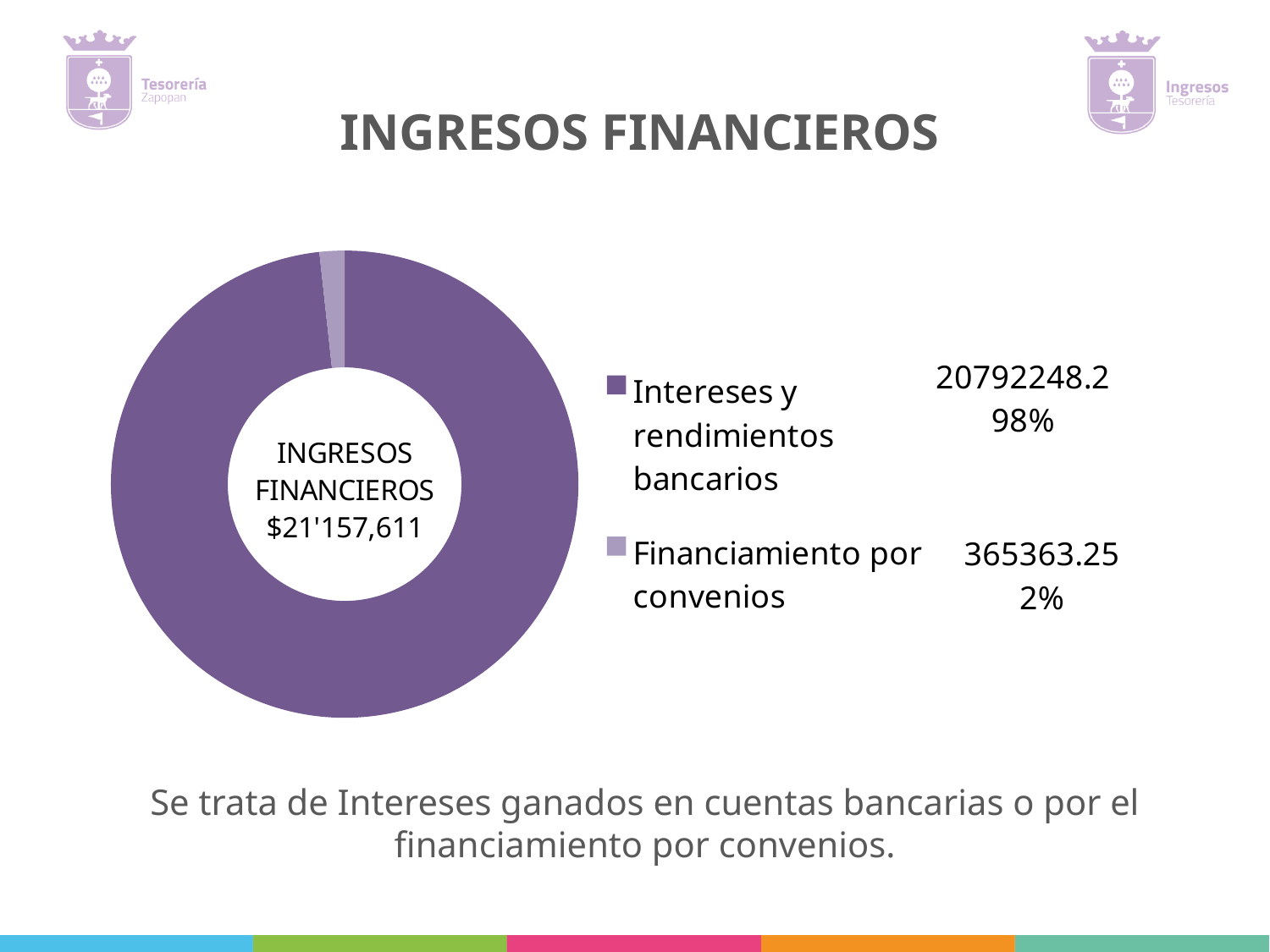
What is the difference between the values for Intereses y rendimientos bancarios and Financiamiento por convenios? 20426884.95 What share of the chart does Intereses y rendimientos bancarios represent? 98% What total is printed in the centre of the doughnut chart? $21'157,611 Which category has the smallest slice? Financiamiento por convenios Which is larger, Intereses y rendimientos bancarios or Financiamiento por convenios? Intereses y rendimientos bancarios What is the value for Intereses y rendimientos bancarios? 20792248.2 Which category has the largest slice? Intereses y rendimientos bancarios What kind of chart is shown on the slide? Doughnut (pie) chart What is the title of the slide containing the chart? INGRESOS FINANCIEROS What is the value for Financiamiento por convenios? 365363.25 How many categories does the chart show? 2 What share of the chart does Financiamiento por convenios represent? 2%